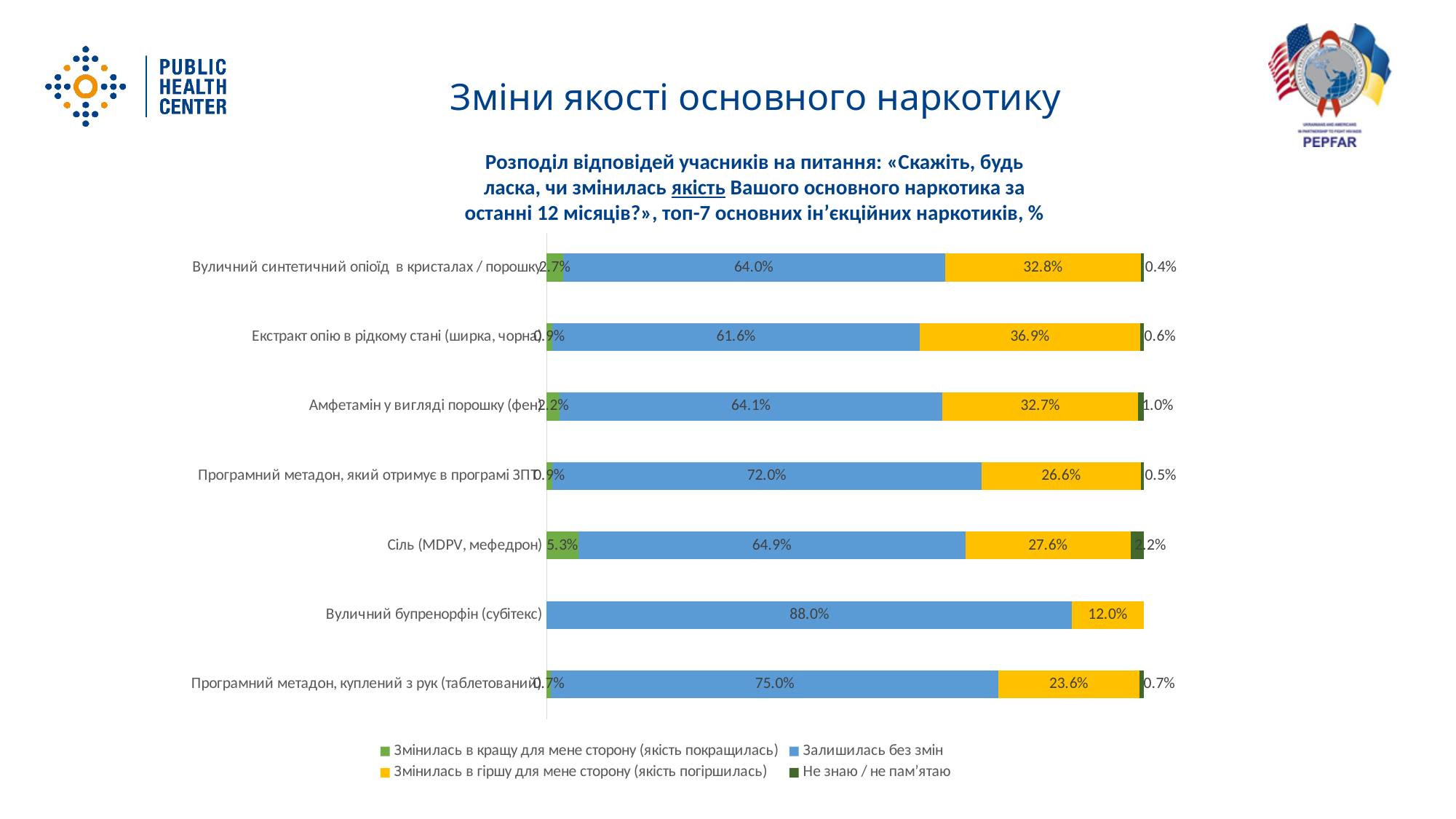
Which drug category has the highest value for «Залишилась без змін»? Вуличний бупренорфін (субітекс) What is the difference between the «Залишилась без змін» values for «Вуличний бупренорфін (субітекс)» and «Програмний метадон, куплений з рук (таблетований)»? 13.0% Which is larger: the «Змінилась в гіршу для мене сторону (якість погіршилась)» value for «Сіль (MDPV, мефедрон)» or for «Програмний метадон, куплений з рук (таблетований)»? Сіль (MDPV, мефедрон) What is the value of «Змінилась в гіршу для мене сторону (якість погіршилась)» for «Екстракт опію в рідкому стані (ширка, чорна)»? 36.9% What is the value of «Залишилась без змін» for «Програмний метадон, який отримує в програмі ЗПТ»? 72.0% What is the value of «Змінилась в кращу для мене сторону (якість покращилась)» for «Сіль (MDPV, мефедрон)»? 5.3% Which drug category has the highest value for «Змінилась в гіршу для мене сторону (якість погіршилась)»? Екстракт опію в рідкому стані (ширка, чорна) Which drug category has the lowest value for «Змінилась в гіршу для мене сторону (якість погіршилась)»? Вуличний бупренорфін (субітекс) What is the value of «Залишилась без змін» for «Вуличний бупренорфін (субітекс)»? 88.0% How many series does the legend list? 4 What kind of chart is shown on the slide? stacked bar chart How many drug categories are listed on the chart? 7